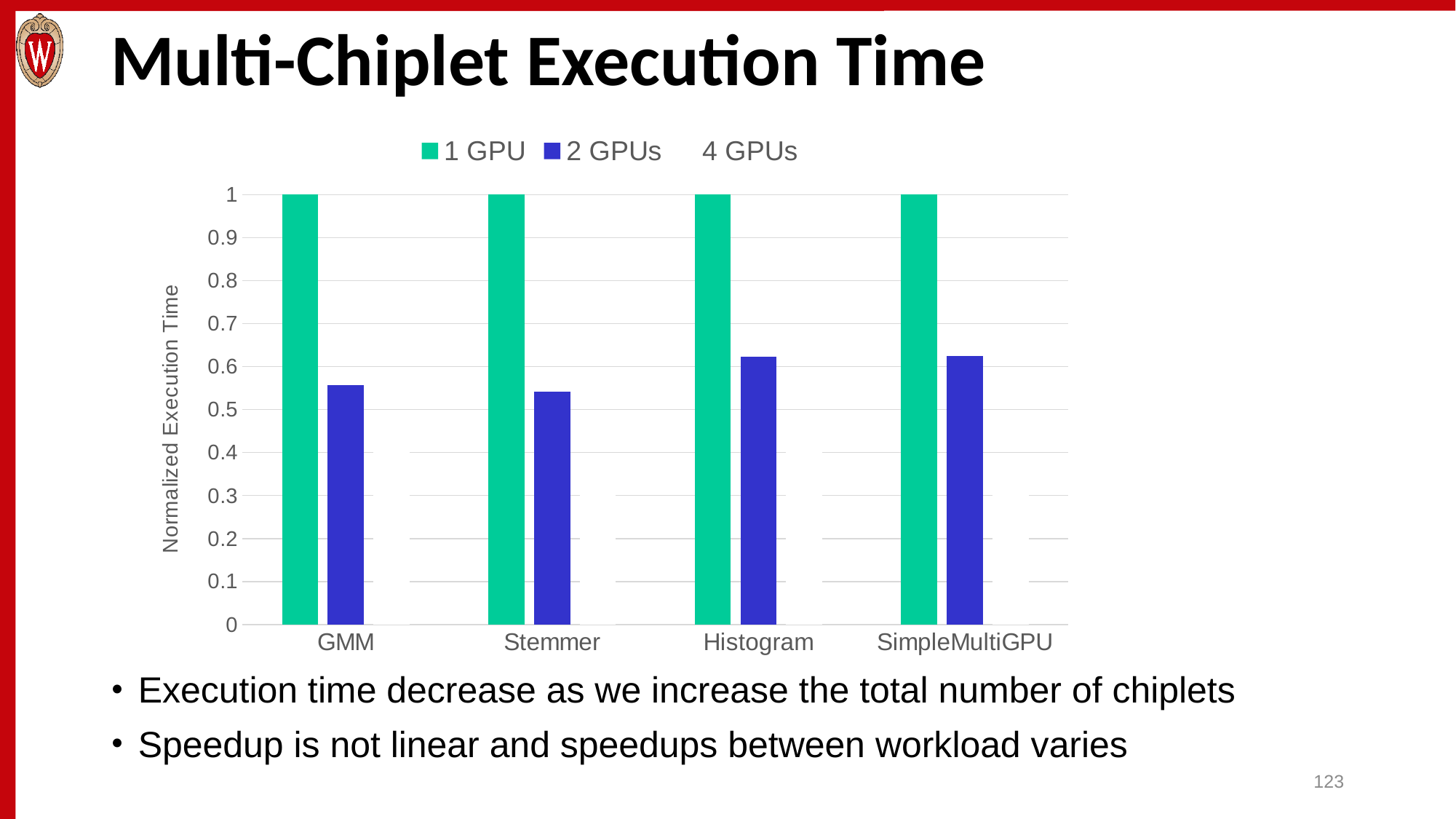
Is the 2 GPUs value for GMM greater or less than 0.6? less Which has the larger 2 GPUs value: GMM or Histogram? Histogram Which is larger for Stemmer: the 1 GPU value or the 2 GPUs value? 1 GPU What kind of chart is shown on the slide? bar chart Is the 2 GPUs value for Stemmer greater or less than 0.6? less What is the normalized execution time for Histogram with 1 GPU? 1 Is the 2 GPUs value for Histogram greater or less than 0.6? greater How many workload categories are shown on the x axis? 4 What is the label on the y axis? Normalized Execution Time How many series does the legend list? 3 What is the normalized execution time for GMM with 1 GPU? 1